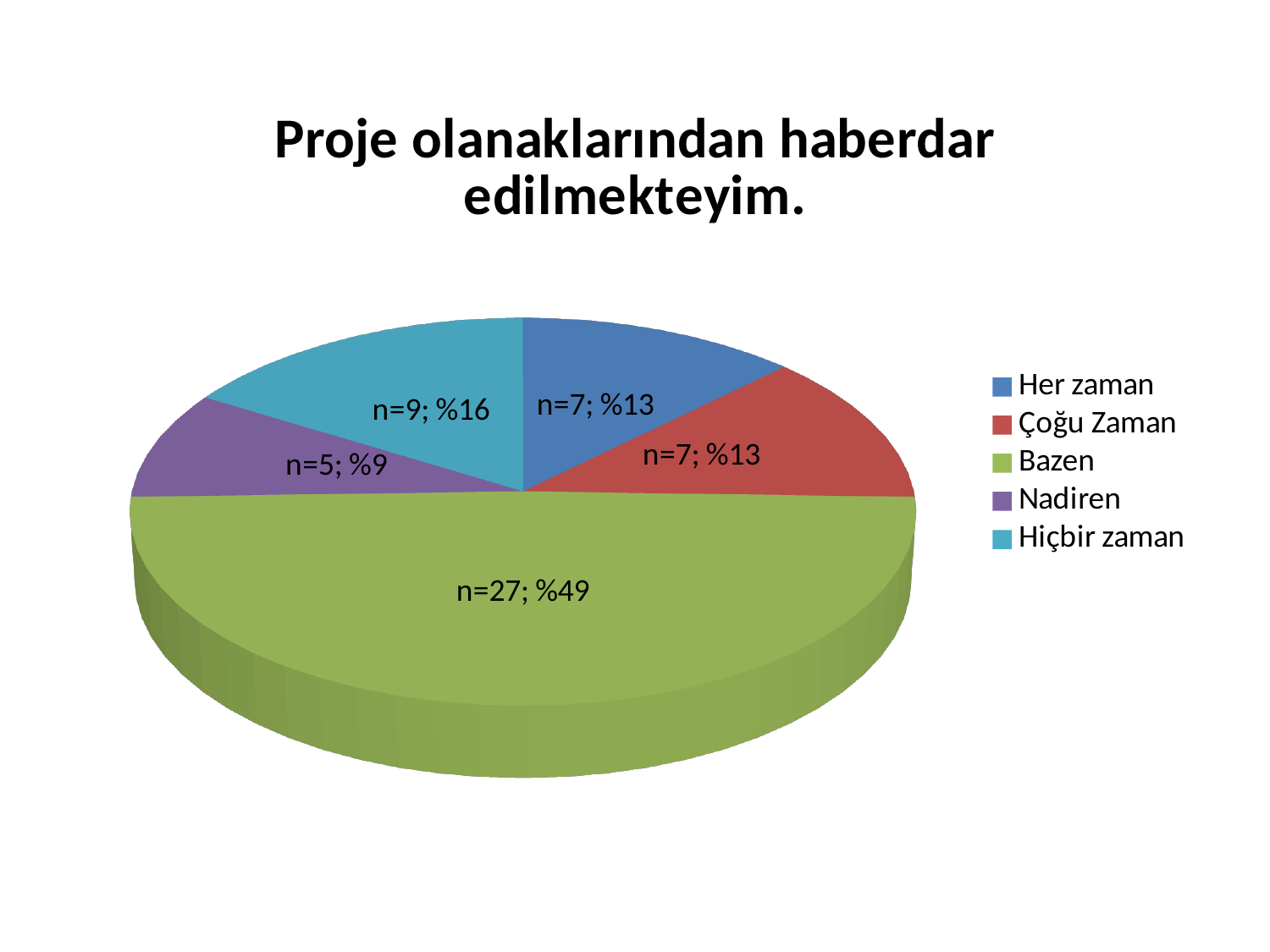
What is the count (n) for the Hiçbir zaman slice? n=9 What percentage share does the Nadiren slice have? %9 Which is larger, the Hiçbir zaman slice or the Nadiren slice? Hiçbir zaman How many categories does the legend list? 5 What is the count (n) for the Her zaman slice? n=7 What kind of chart is shown on the slide? Pie chart What is the difference in count (n) between the Bazen slice and the Hiçbir zaman slice? 18 Which category has the largest slice? Bazen What is the count (n) for the Bazen slice? n=27 What percentage share does the Bazen slice have? %49 Which category has the smallest slice? Nadiren What is the title of the chart? Proje olanaklarından haberdar edilmekteyim.